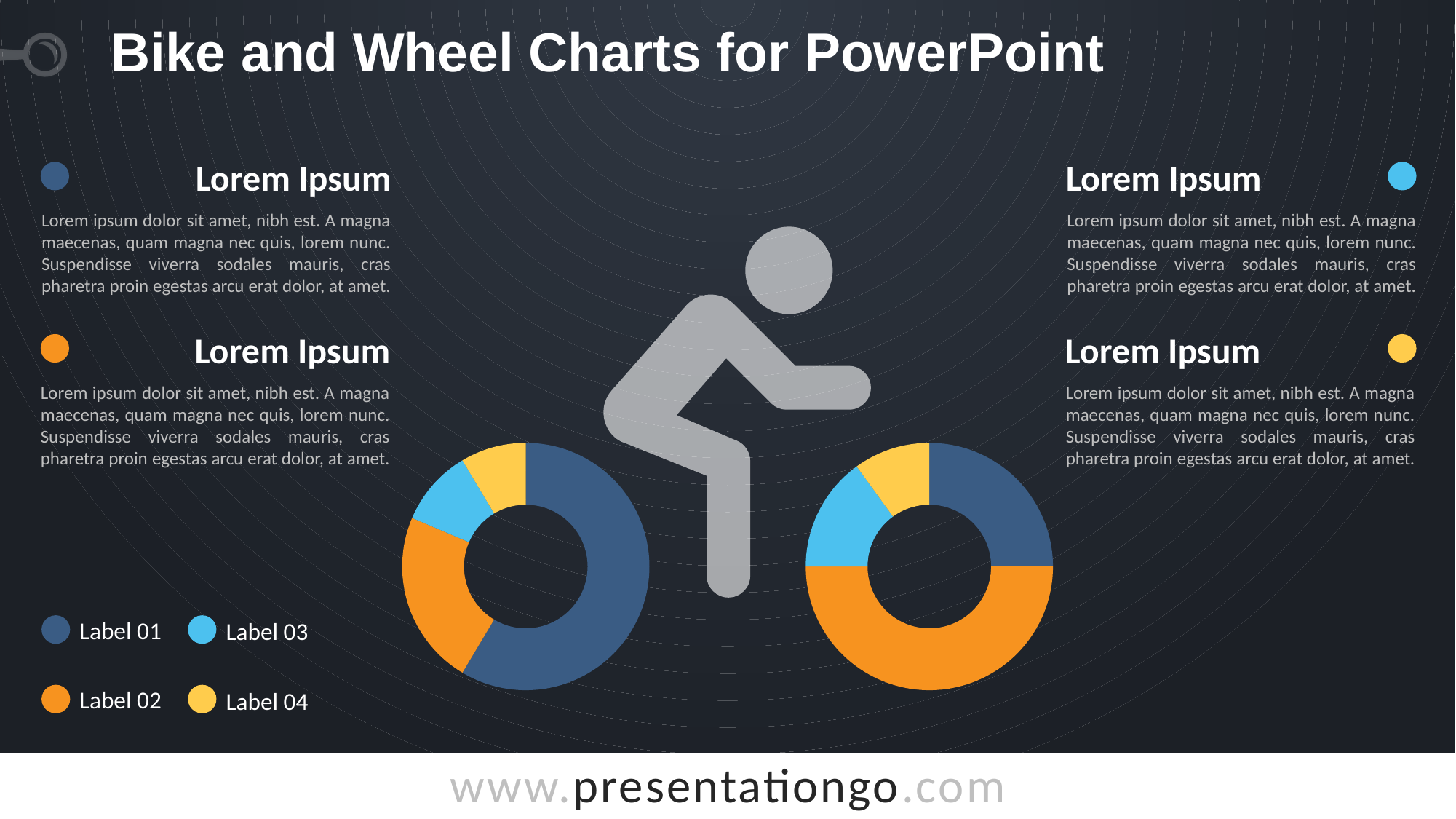
What is the title of the slide? Bike and Wheel Charts for PowerPoint How many categories does the legend list? 4 In the left wheel chart, which is larger, Label 01 or Label 02? Label 01 In the right wheel chart, which is larger, Label 01 or Label 04? Label 01 In the right wheel chart, which category has the largest slice? Label 02 What kind of chart is the right bike wheel? doughnut chart In the left wheel chart, which is larger, Label 02 or Label 03? Label 02 What colour represents Label 02 in the legend? orange In the left wheel chart, which category has the largest slice? Label 01 What kind of chart is the left bike wheel? doughnut chart How many charts are shown on the slide? 2